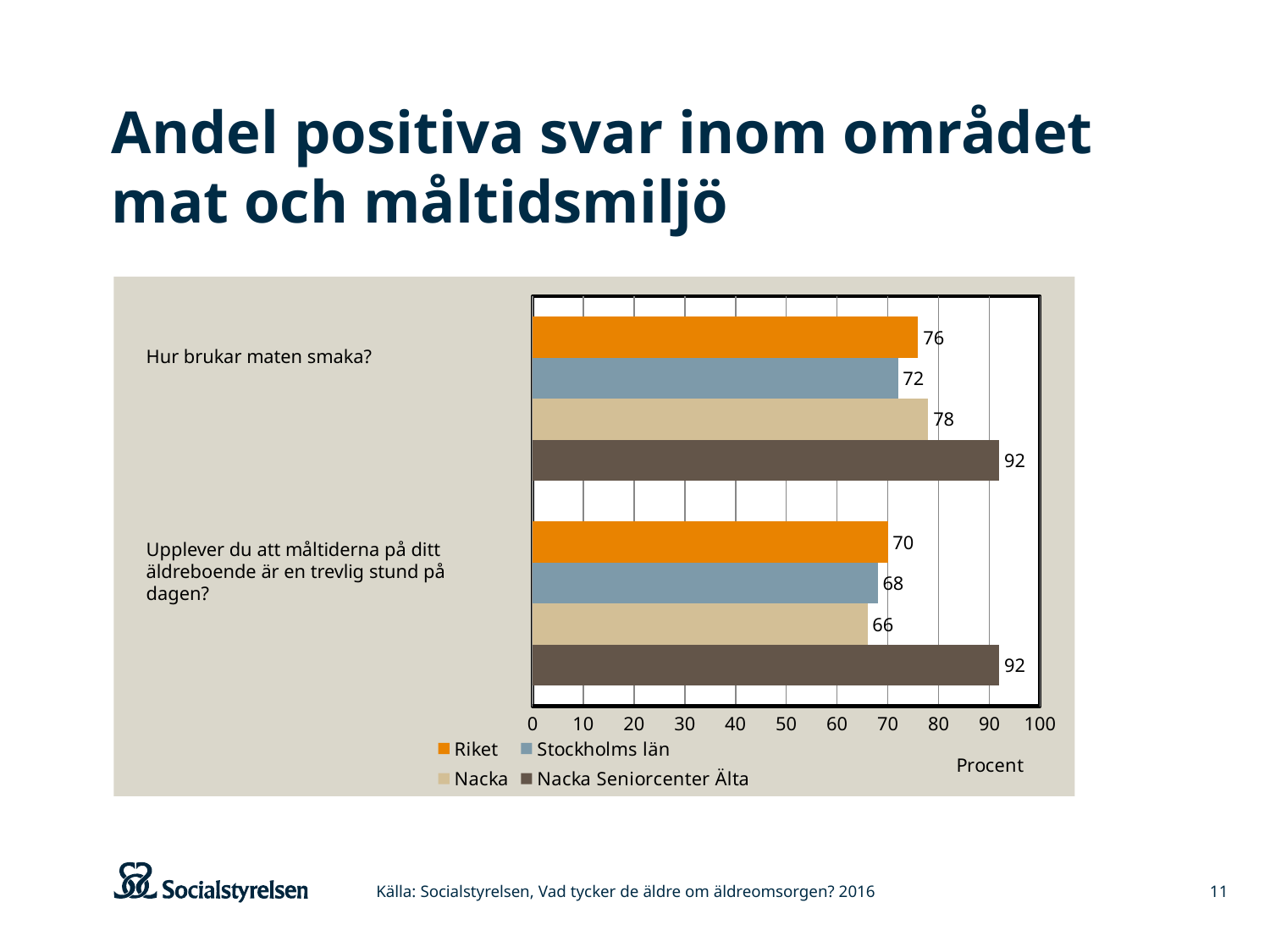
Which series has the highest value for the question "Hur brukar maten smaka?"? Nacka Seniorcenter Älta What is the difference between Nacka Seniorcenter Älta and Riket for the question "Hur brukar maten smaka?"? 16 Which series has the lowest value for the question "Upplever du att måltiderna på ditt äldreboende är en trevlig stund på dagen?"? Nacka What is the value for Nacka for the question "Upplever du att måltiderna på ditt äldreboende är en trevlig stund på dagen?"? 66 How many series does the legend list? 4 How many questions (categories) are shown on the chart? 2 What is the value for Nacka Seniorcenter Älta for the question "Upplever du att måltiderna på ditt äldreboende är en trevlig stund på dagen?"? 92 What is the value for Riket for the question "Hur brukar maten smaka?"? 76 What kind of chart is shown on the slide? Bar chart Which is larger for the question "Hur brukar maten smaka?": Nacka or Stockholms län? Nacka What is the label on the horizontal axis of the chart? Procent What is the value for Stockholms län for the question "Hur brukar maten smaka?"? 72